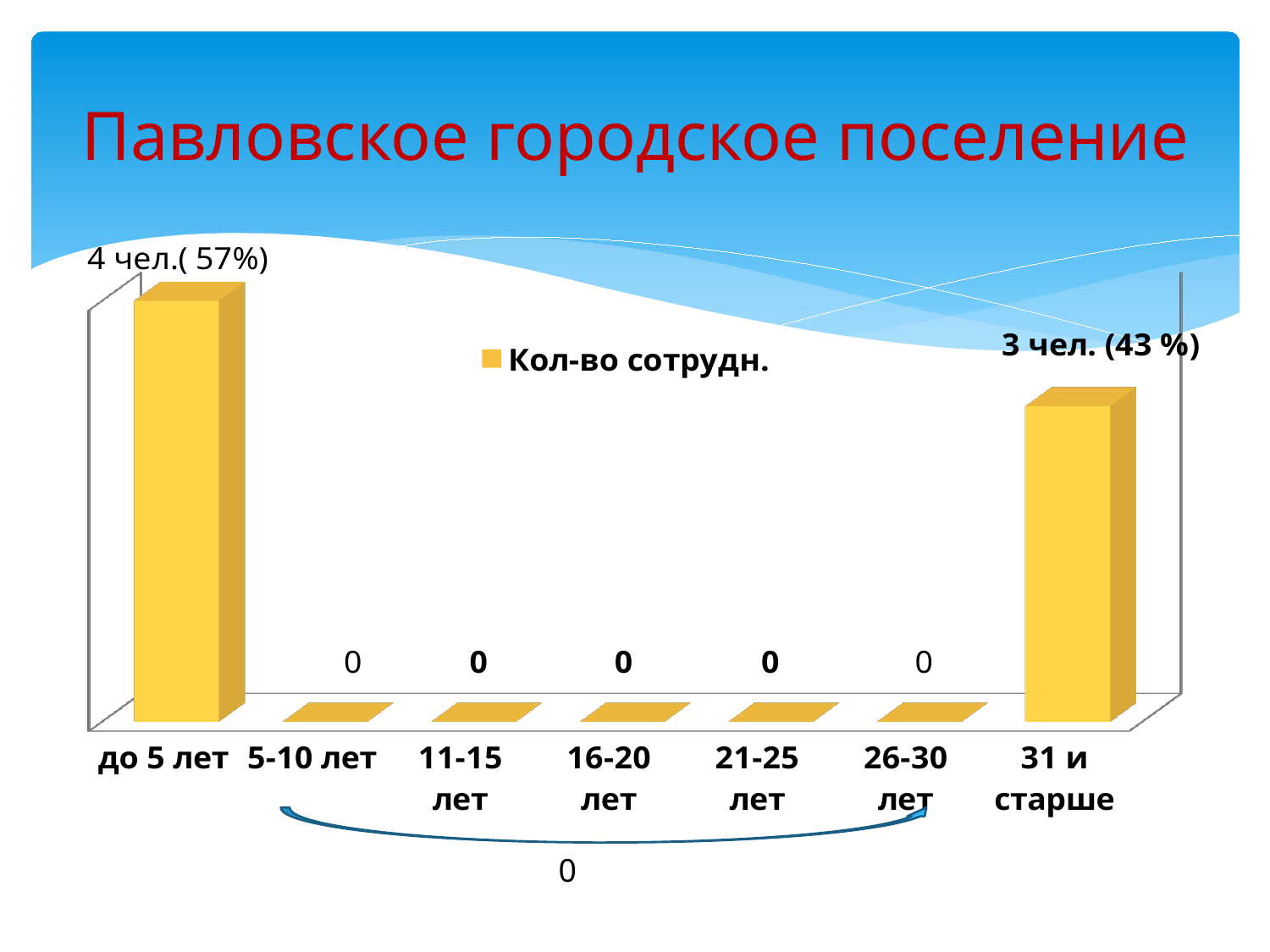
What is the title of the slide? Павловское городское поселение What kind of chart is shown on the slide? bar chart Which of the two categories has the larger value: 'до 5 лет' or '31 и старше'? до 5 лет Which category has the highest value? до 5 лет How many categories are shown on the x axis? 7 What is the name of the series in the legend? Кол-во сотрудн. What is the data label shown for the '31 и старше' category? 3 чел. (43 %) What is the difference in number of people between 'до 5 лет' and '31 и старше'? 1 чел. What value is shown for the '16-20 лет' category? 0 How many series does the legend list? 1 What is the data label shown for the 'до 5 лет' category? 4 чел.( 57%) How many categories have a value of 0? 5